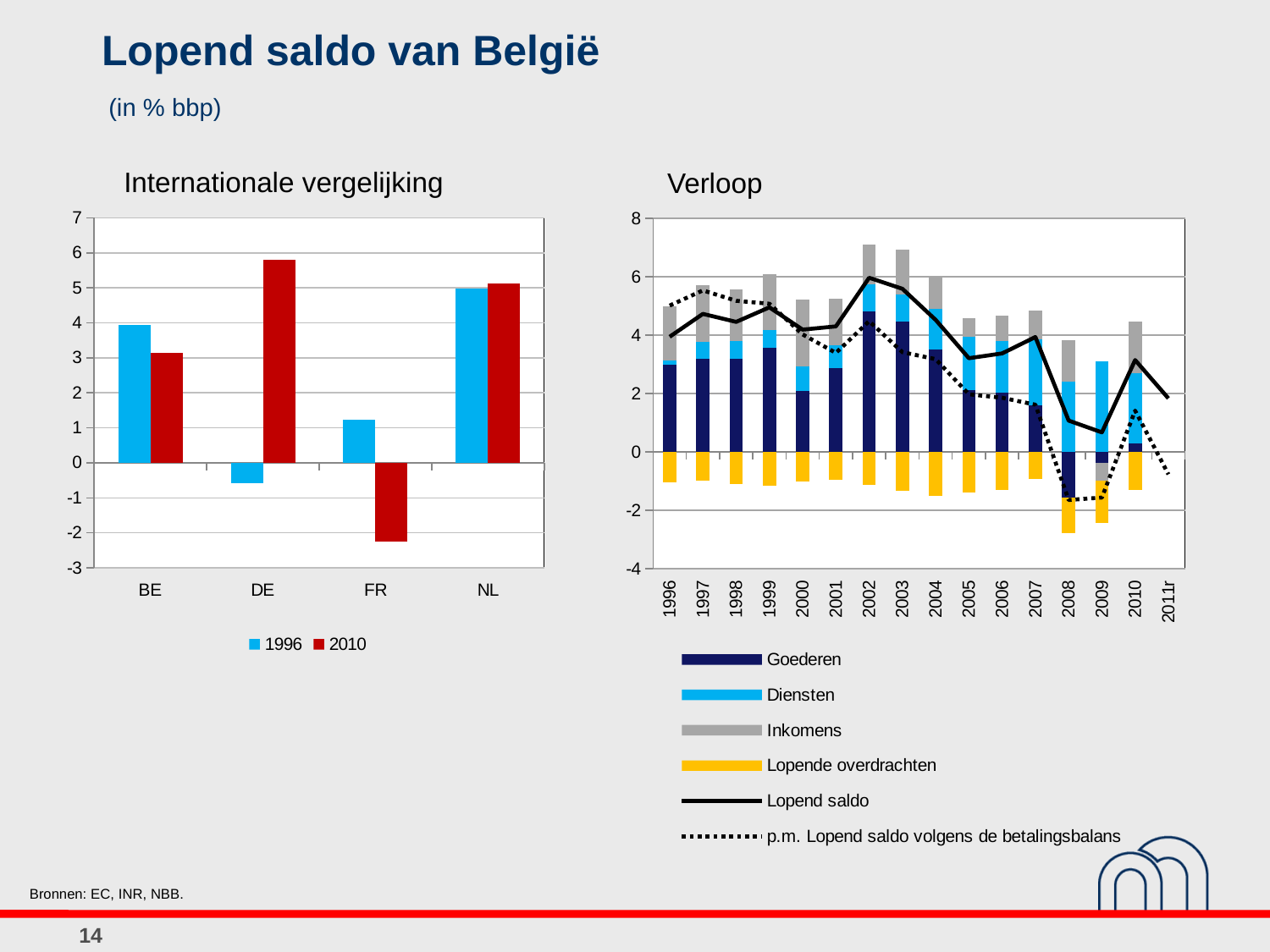
On the 'Verloop' chart, does the 'Lopend saldo' line generally rise or fall between 2002 and 2009? fall On the 'Internationale vergelijking' chart, is the 2010 value for DE greater or less than 5? greater What kind of chart is the 'Internationale vergelijking' chart? bar chart On the 'Internationale vergelijking' chart, which country has the lowest value for 2010? FR On the 'Internationale vergelijking' chart, is the 1996 value for BE greater or less than 3? greater On the 'Internationale vergelijking' chart, is the 2010 value for FR greater or less than -1? less On the 'Internationale vergelijking' chart, which is larger for BE: the 1996 value or the 2010 value? 1996 On the 'Verloop' chart, how many series does the legend list? 6 On the 'Verloop' chart, in which year does the 'Lopend saldo' line reach its highest value? 2002 On the 'Internationale vergelijking' chart, how many countries are shown on the x axis? 4 On the 'Internationale vergelijking' chart, which country has the highest value for 2010? DE On the 'Internationale vergelijking' chart, which country has the lowest value for 1996? DE